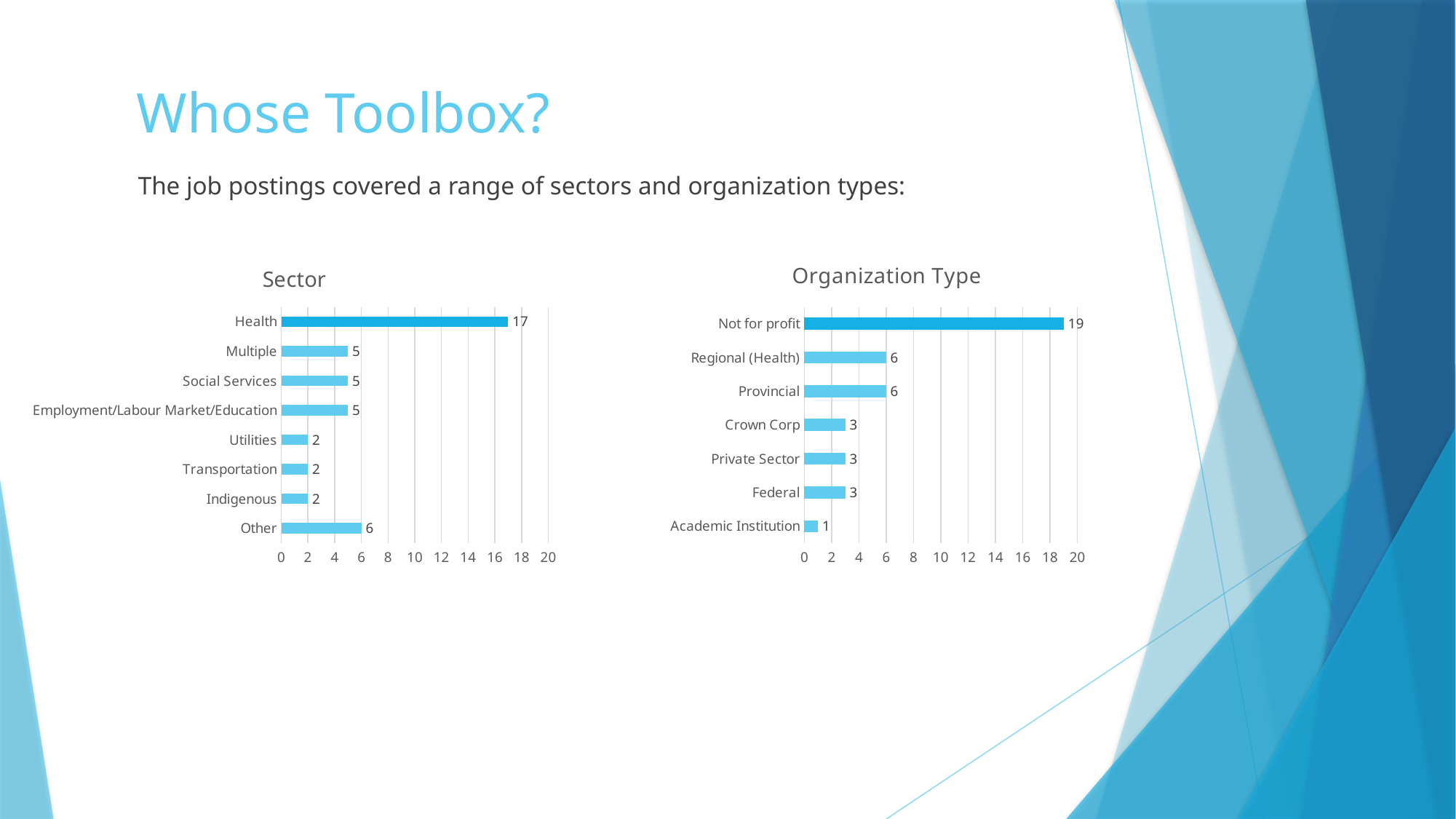
In the Sector chart, what is the value for Health? 17 In the Organization Type chart, which is larger, the value for Regional (Health) or the value for Crown Corp? Regional (Health) In the Organization Type chart, which category has the lowest value? Academic Institution How many categories are shown in the Organization Type chart? 7 In the Sector chart, which category has the highest value? Health What kind of chart is the Organization Type chart? Bar chart How many categories are shown in the Sector chart? 8 In the Organization Type chart, what is the value for Academic Institution? 1 In the Sector chart, what is the difference between the values for Health and Other? 11 In the Organization Type chart, what is the difference between the values for Not for profit and Provincial? 13 In the Organization Type chart, what is the value for Not for profit? 19 In the Sector chart, what is the value for Other? 6